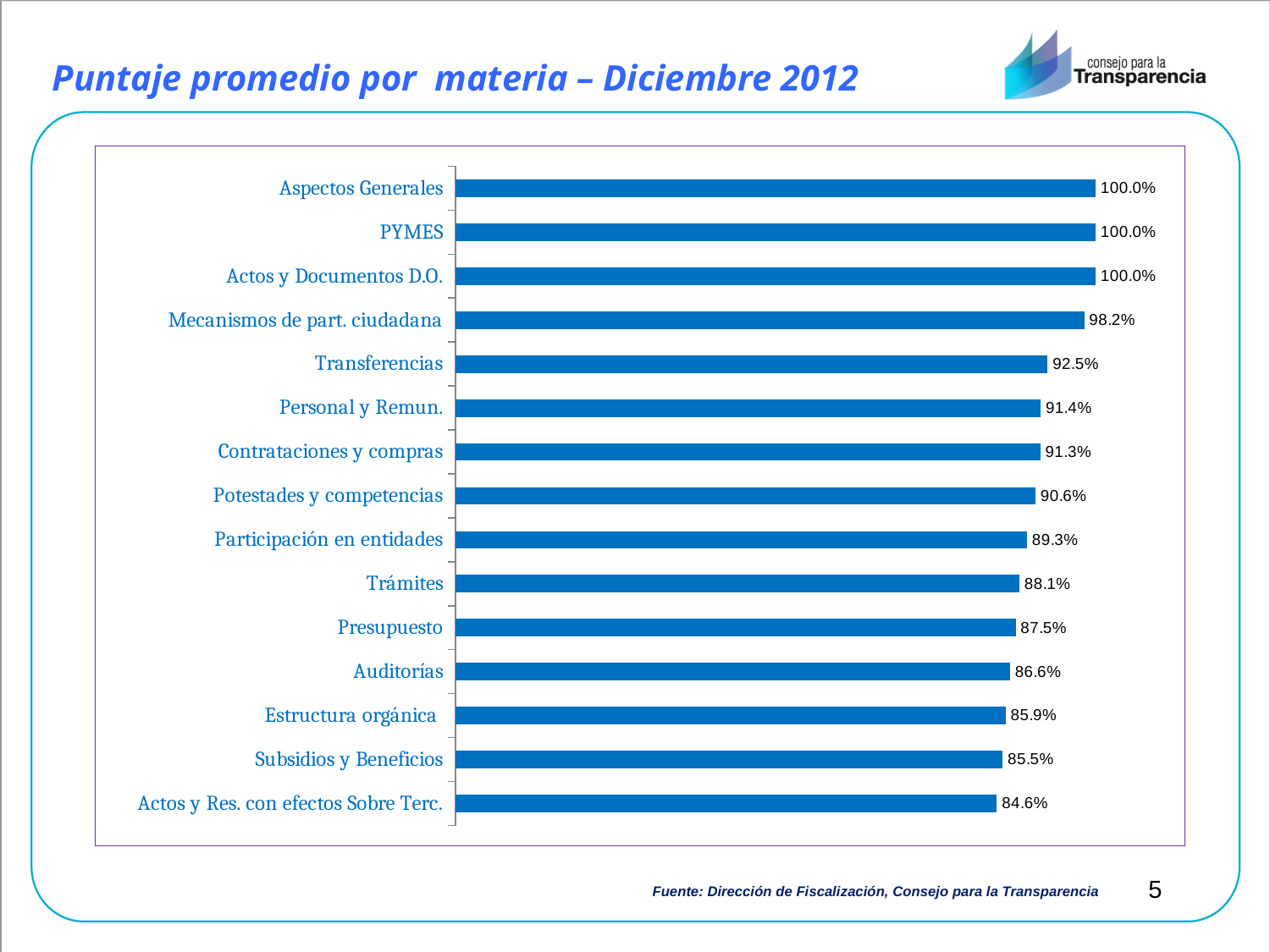
How many categories reach 100.0%? 3 What is the difference between the values for Mecanismos de part. ciudadana and Actos y Res. con efectos Sobre Terc.? 13.6 percentage points What kind of chart is shown on the slide? Bar chart What is the value for Presupuesto? 87.5% What is the value for Mecanismos de part. ciudadana? 98.2% What is the value for Subsidios y Beneficios? 85.5% What is the title of the slide containing the chart? Puntaje promedio por materia – Diciembre 2012 How many categories are shown in the chart? 15 What is the value for Transferencias? 92.5% What is the difference between the values for Transferencias and Personal y Remun.? 1.1 percentage points Which has a larger value, Auditorías or Estructura orgánica? Auditorías Which category has the lowest value? Actos y Res. con efectos Sobre Terc.